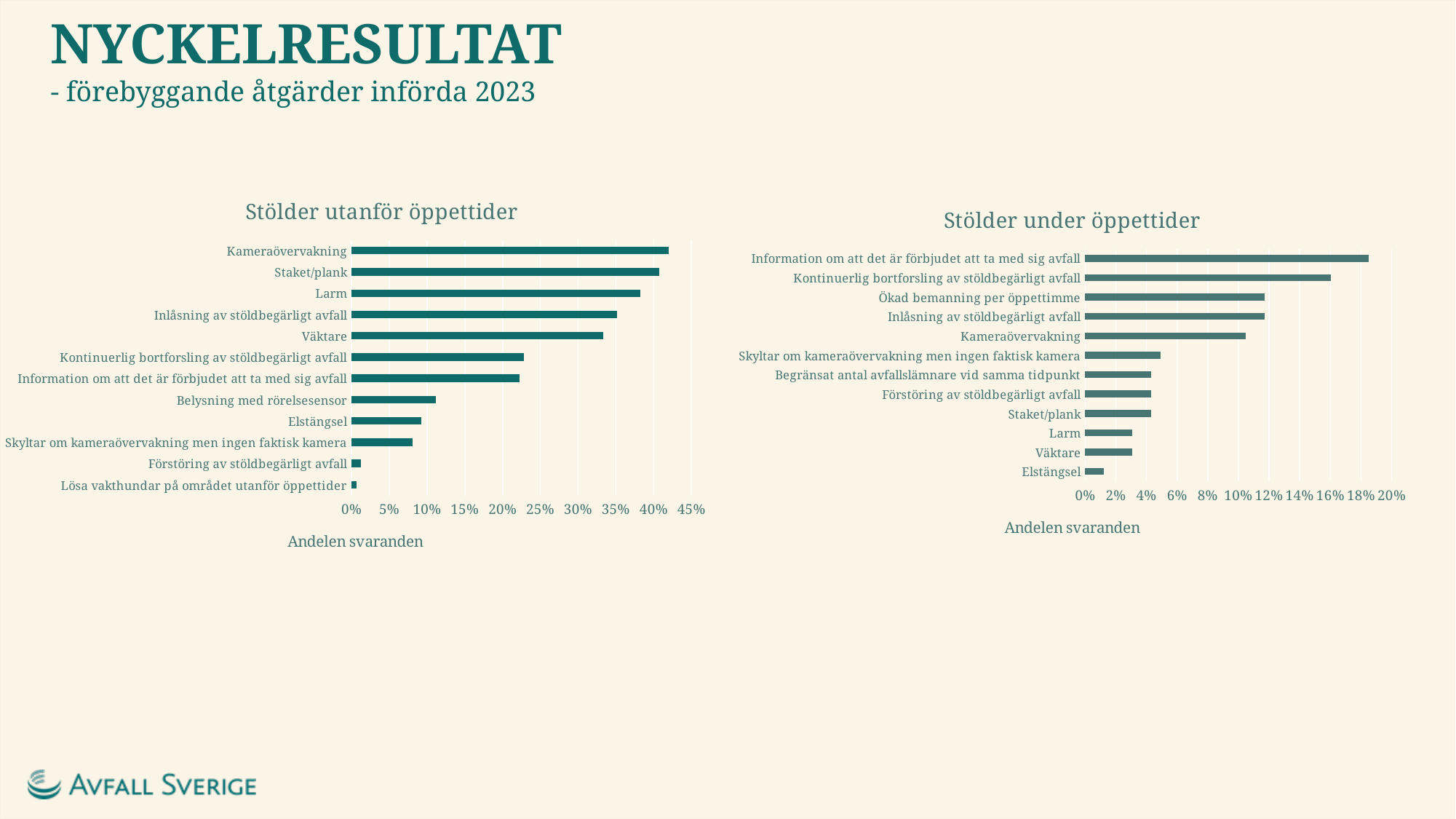
In the chart titled 'Stölder utanför öppettider', is the value for Kameraövervakning greater or less than 40%? greater In the chart titled 'Stölder under öppettider', which category has the lowest value? Elstängsel In the chart titled 'Stölder utanför öppettider', which category has the highest value? Kameraövervakning In the chart titled 'Stölder utanför öppettider', which has a larger value: Väktare or Elstängsel? Väktare In the chart titled 'Stölder under öppettider', which category has the highest value? Information om att det är förbjudet att ta med sig avfall What kind of chart is the chart titled 'Stölder utanför öppettider'? Bar chart How many categories are shown in the chart titled 'Stölder under öppettider'? 12 In the chart titled 'Stölder under öppettider', which has a larger value: Kameraövervakning or Skyltar om kameraövervakning men ingen faktisk kamera? Kameraövervakning In the chart titled 'Stölder utanför öppettider', is the value for Belysning med rörelsesensor greater or less than 15%? less In the chart titled 'Stölder under öppettider', is the value for Kontinuerlig bortforsling av stöldbegärligt avfall greater or less than 14%? greater In the chart titled 'Stölder utanför öppettider', which category has the lowest value? Lösa vakthundar på området utanför öppettider